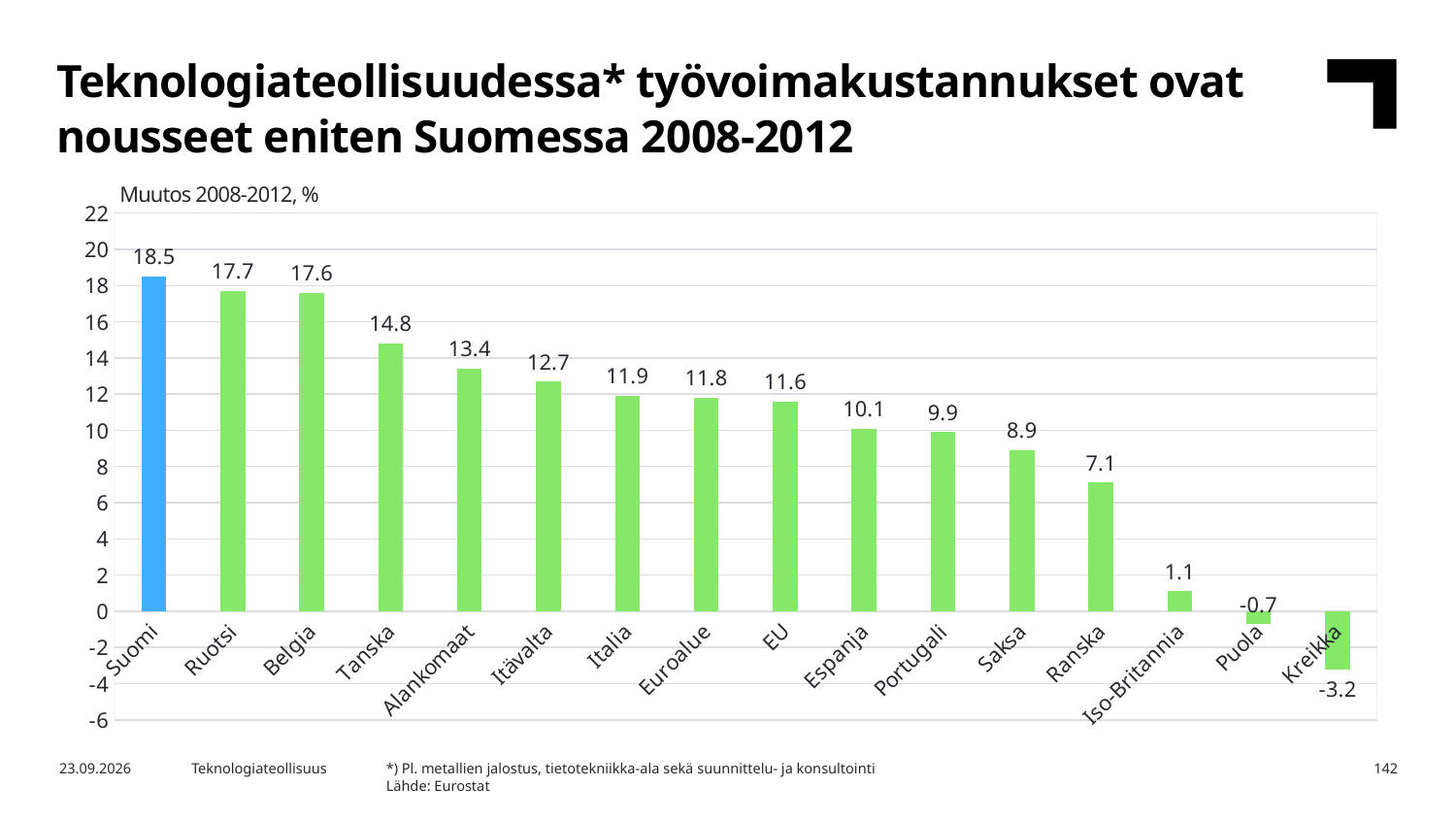
Do the values rise or fall from left to right along the x axis? Fall Which bar is coloured differently from the others? Suomi Which is larger, the value for Espanja or the value for Ranska? Espanja What kind of chart is shown on the slide? Bar chart What is the difference between the values for Suomi and Ruotsi? 0.8 What is the value for Alankomaat? 13.4 What is the value for Kreikka? -3.2 What is the value for Suomi? 18.5 Which country has the highest value? Suomi Which country has the lowest value? Kreikka How many categories are shown on the x axis? 16 What is the difference between the values for Tanska and Saksa? 5.9